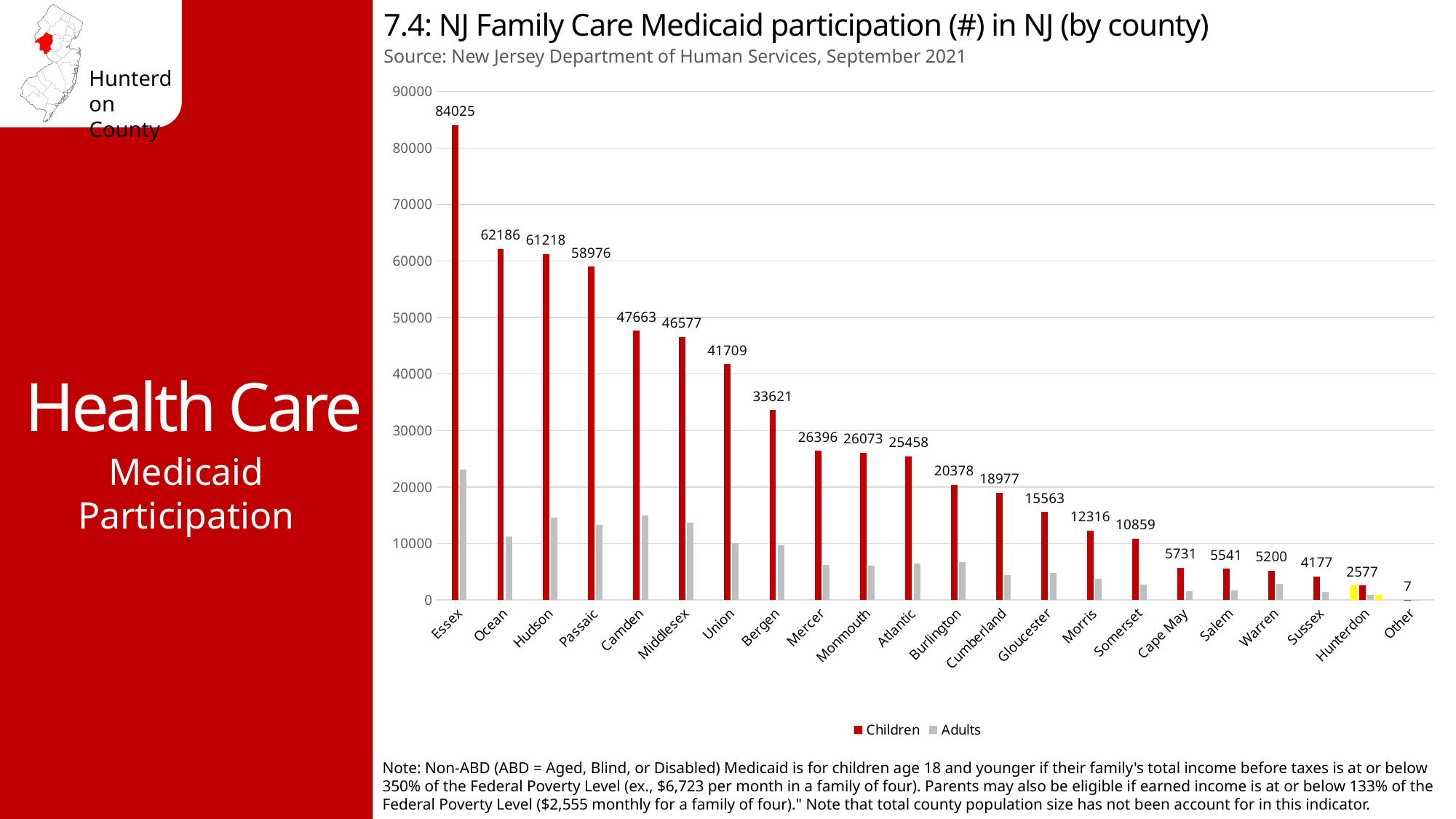
Which county's bars are highlighted in yellow? Hunterdon Which category has the highest Children value? Essex What is the difference between the Children values for Ocean and Hudson? 968 How many series does the legend list? 2 What kind of chart is shown on the slide? bar chart Which has the larger Children value, Camden or Middlesex? Camden How many categories are shown on the x axis? 22 Which category has the lowest Children value? Other Do the Children values rise or fall from left to right along the x axis? fall Is the Adults value for Essex greater or less than 20000? greater What is the Children value for Hunterdon? 2577 What is the Children value for Essex? 84025